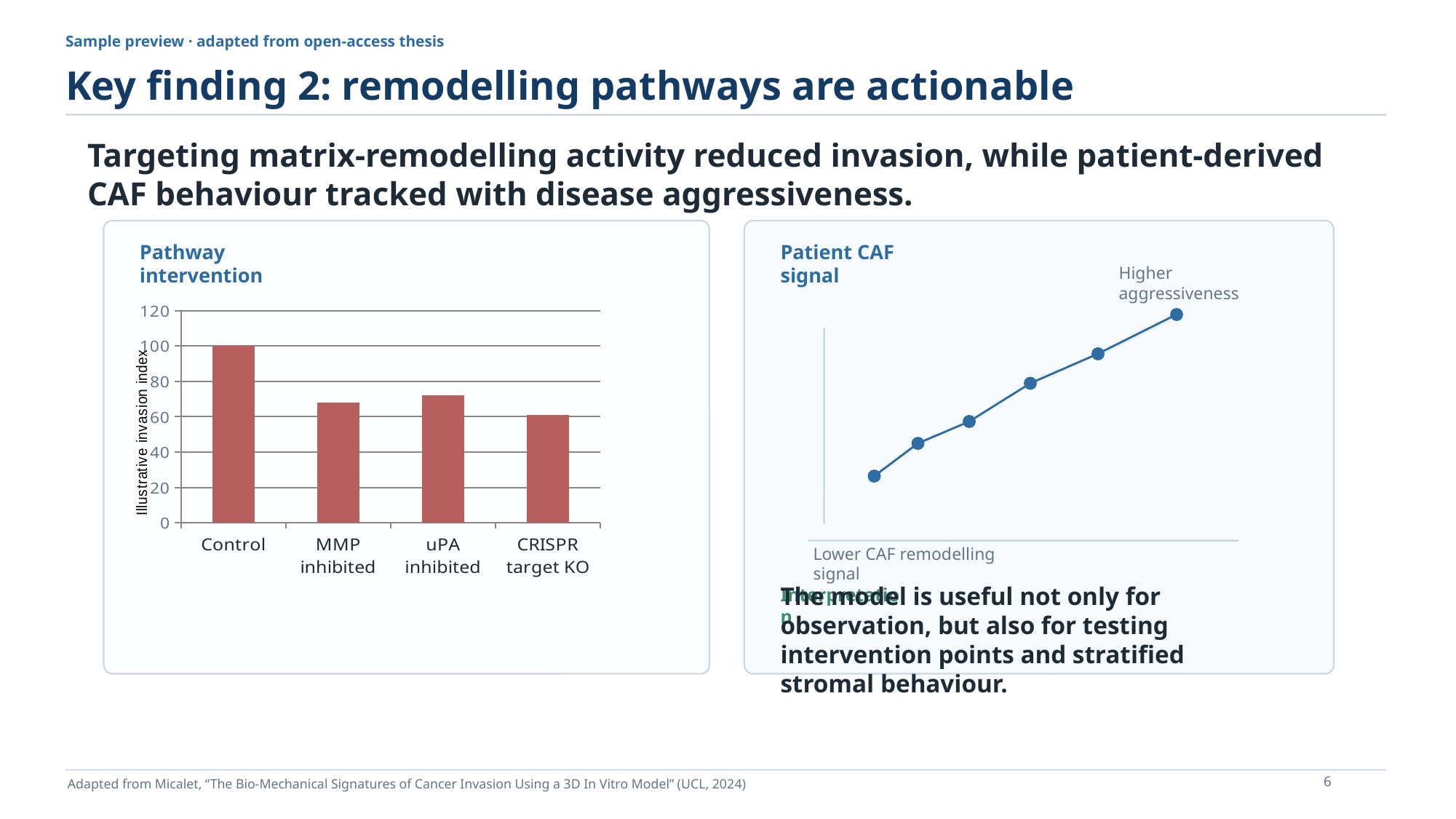
On the Pathway intervention chart, which is larger, the value for Control or the value for uPA inhibited? Control On the Pathway intervention chart, how many categories are plotted? 4 On the Pathway intervention chart, is the value for MMP inhibited greater or less than 80? less On the Pathway intervention chart, is the value for uPA inhibited greater or less than 60? greater On the Pathway intervention chart, is the value for CRISPR target KO greater or less than 80? less On the Patient CAF signal chart, what kind of chart is shown? line chart On the Pathway intervention chart, what kind of chart is shown? bar chart On the Patient CAF signal chart, how many data points are plotted? 6 On the Pathway intervention chart, what is the illustrative invasion index for Control? 100 On the Pathway intervention chart, which category has the highest illustrative invasion index? Control On the Pathway intervention chart, which category has the lowest illustrative invasion index? CRISPR target KO On the Patient CAF signal chart, do the values rise or fall from left to right? rise